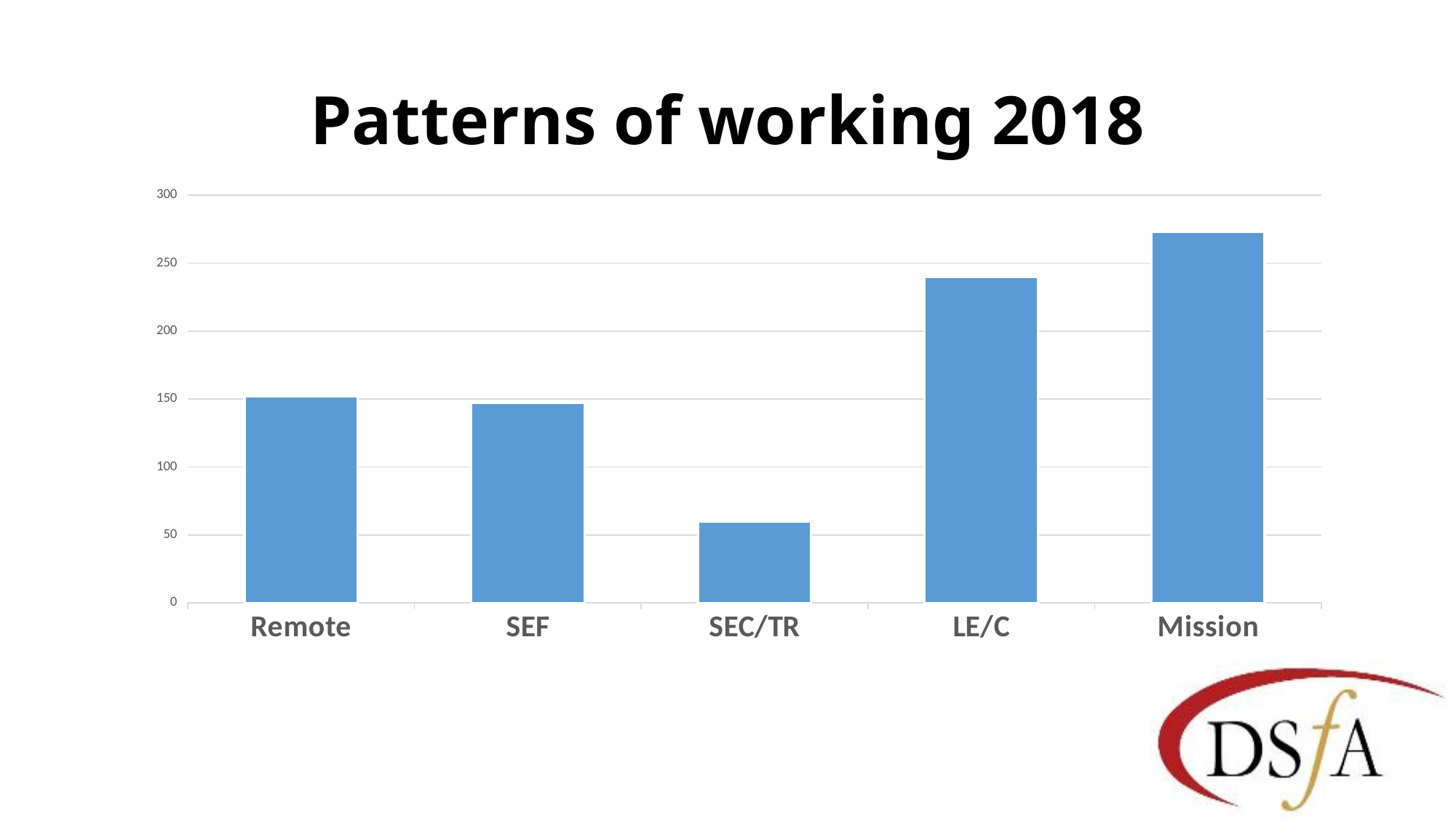
Is the value for SEF greater or less than 200? less Is the value for Remote greater or less than 100? greater Is the value for SEC/TR greater or less than 100? less How many categories are shown on the x axis of the chart? 5 Which category has the lowest value? SEC/TR Which category has the highest value? Mission What is the title of the chart? Patterns of working 2018 Which is larger, the value for LE/C or the value for Mission? Mission What kind of chart is shown on the slide? bar chart Which is larger, the value for SEC/TR or the value for SEF? SEF